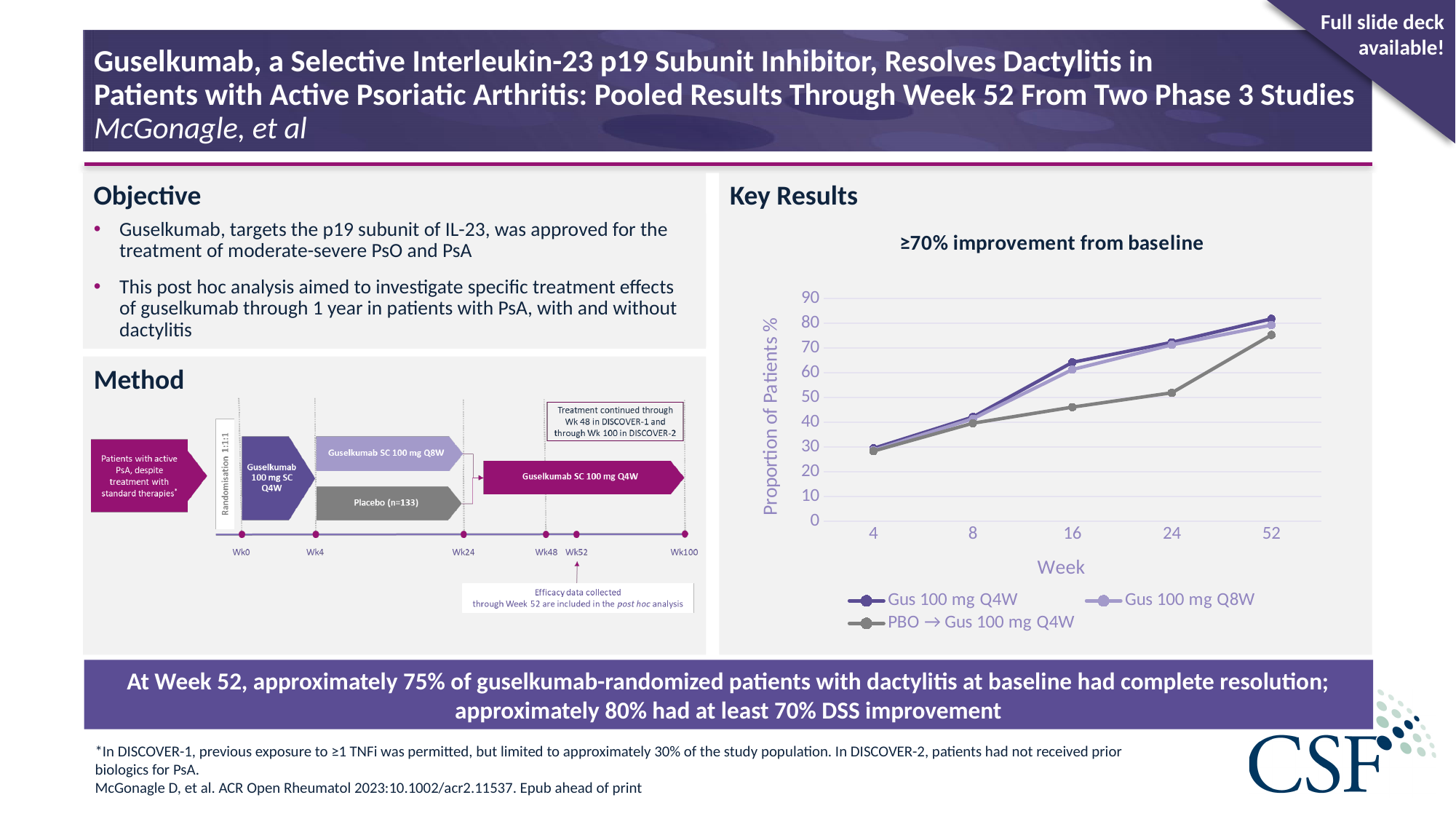
In the Key Results chart, at Week 16, which is larger: Gus 100 mg Q4W or PBO → Gus 100 mg Q4W? Gus 100 mg Q4W In the Key Results chart, is the value for PBO → Gus 100 mg Q4W at Week 24 greater or less than 60? less In the Key Results chart, is the value for Gus 100 mg Q4W at Week 52 greater or less than 70? greater In the Key Results chart, which series has the lowest value at Week 24? PBO → Gus 100 mg Q4W How many week time points are plotted on the x axis of the Key Results chart? 5 What kind of chart is shown under Key Results? Line chart What is the title of the Key Results chart? ≥70% improvement from baseline What is the y-axis label of the Key Results chart? Proportion of Patients % In the Key Results chart, is the value for PBO → Gus 100 mg Q4W at Week 52 greater or less than 70? greater How many series does the legend of the Key Results chart list? 3 In the Key Results chart, do the values for Gus 100 mg Q4W rise or fall from Week 4 to Week 52? Rise